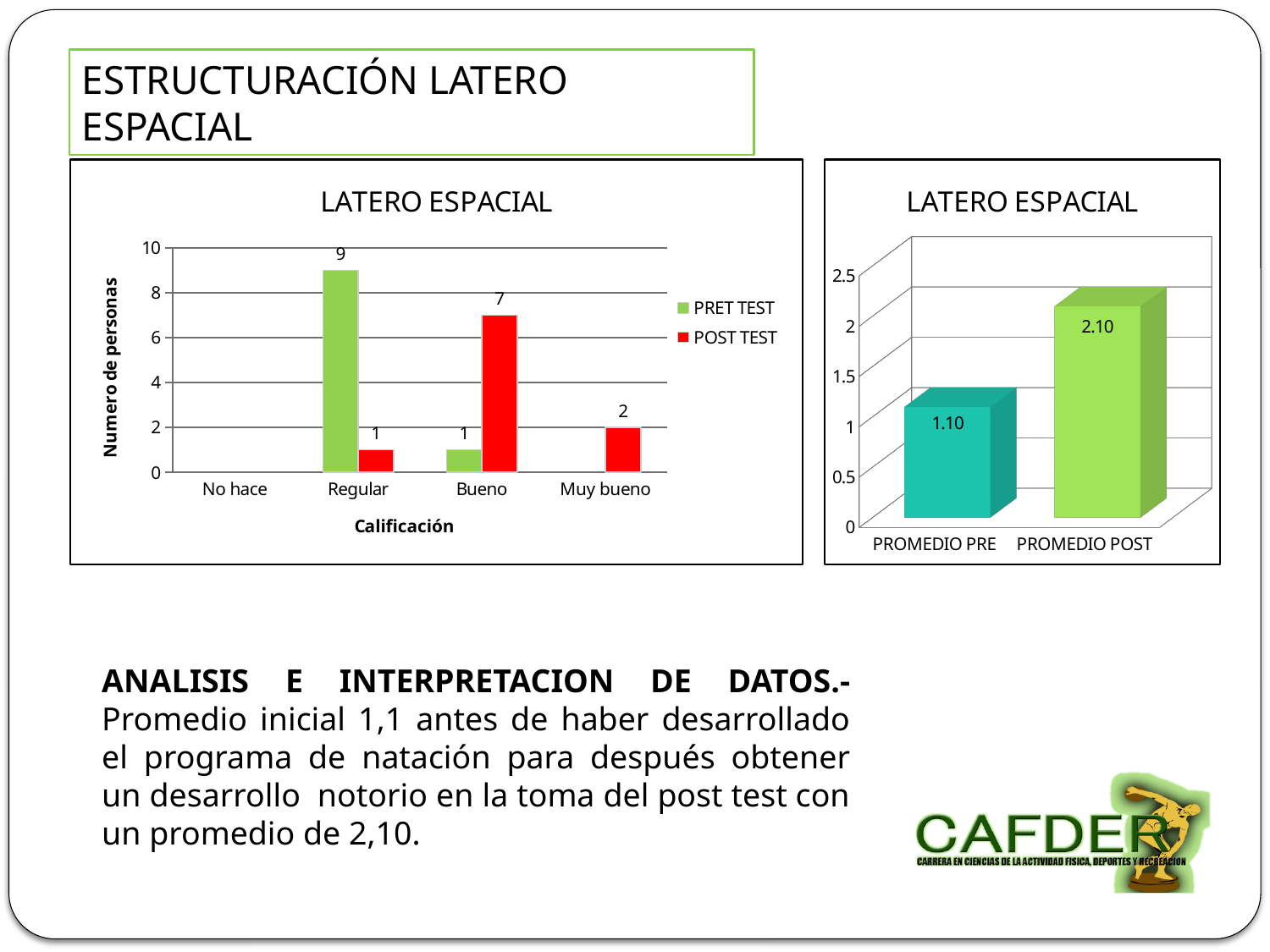
What kind of chart is the right chart? Bar chart In the left chart, how many categories are shown on the x axis? 4 In the left chart, how many series does the legend list? 2 In the left chart, which is larger for Bueno: PRET TEST or POST TEST? POST TEST In the left chart, what is the PRET TEST value for Regular? 9 In the right chart, what is the difference between PROMEDIO POST and PROMEDIO PRE? 1.00 In the left chart, what is the difference between the PRET TEST and POST TEST values for Regular? 8 In the left chart, what is the POST TEST value for Bueno? 7 In the left chart, which category has the highest POST TEST value? Bueno In the left chart, what is the label of the y axis? Numero de personas In the right chart, what is the value for PROMEDIO POST? 2.10 In the left chart, what is the POST TEST value for Muy bueno? 2